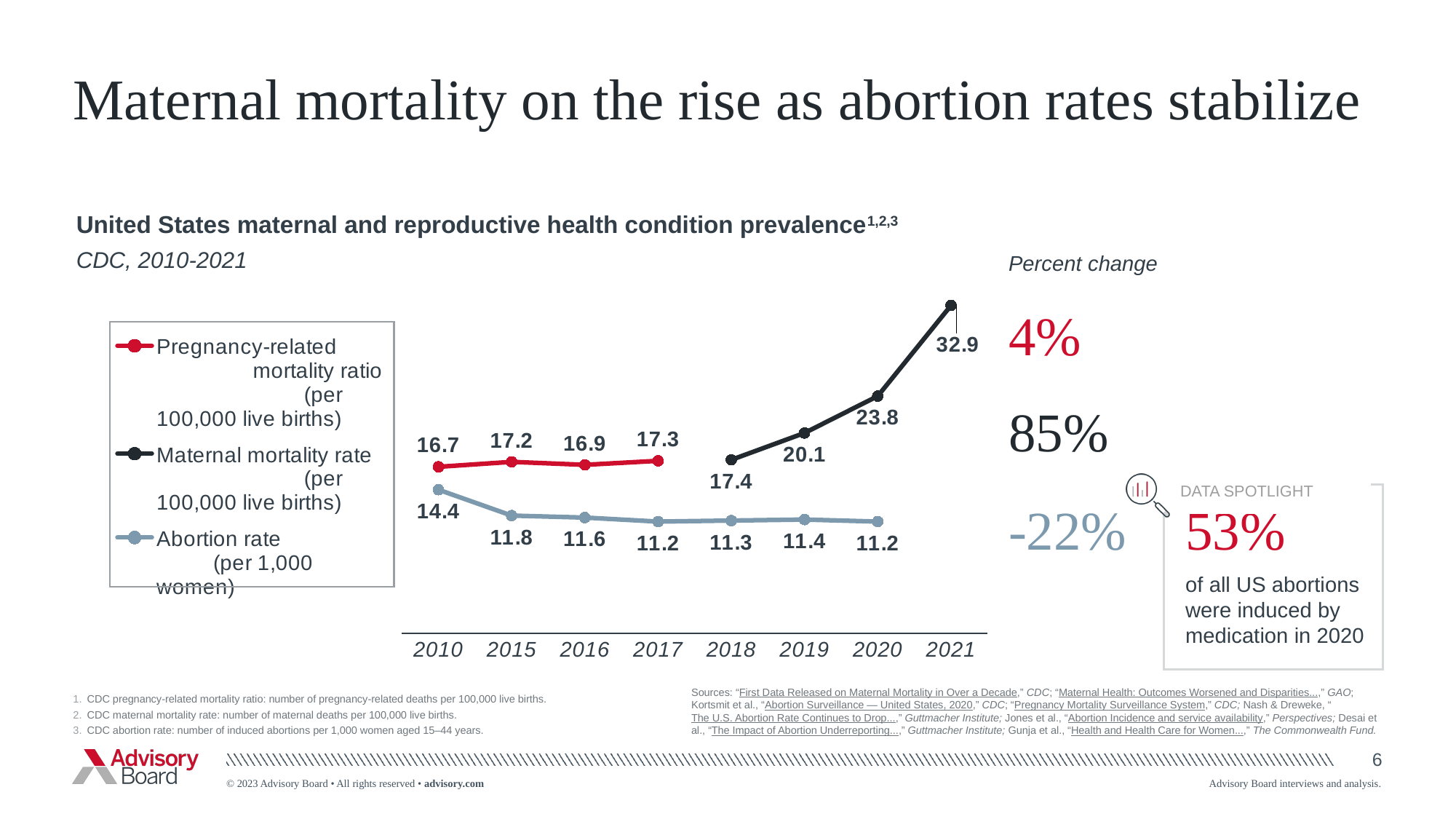
How many years are labeled on the x axis of the chart? 8 What is the maternal mortality rate in 2021? 32.9 How many series does the chart legend list? 3 What percent change is shown for the abortion rate? -22% What is the difference between the maternal mortality rate in 2021 and in 2018? 15.5 In which year is the maternal mortality rate highest? 2021 Does the maternal mortality rate rise or fall from 2018 to 2021? rise Which is larger, the abortion rate in 2015 or the abortion rate in 2019? 2015 What type of chart is shown on the slide? line chart What is the pregnancy-related mortality ratio in 2016? 16.9 What is the abortion rate in 2010? 14.4 In which year is the pregnancy-related mortality ratio lowest? 2010